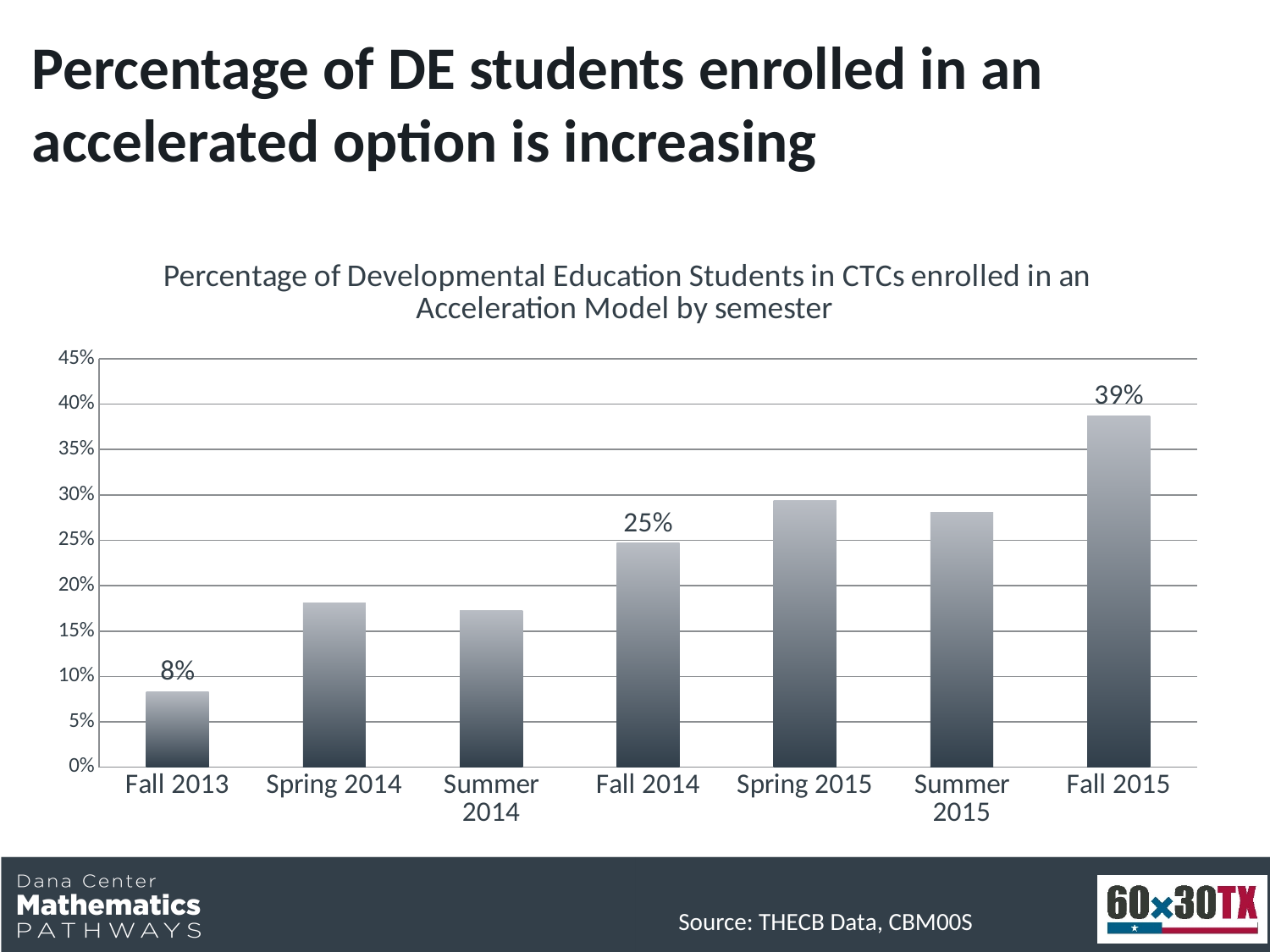
Is the value for Spring 2014 greater or less than 20%? less Which is larger, the value for Spring 2015 or the value for Summer 2014? Spring 2015 Which semester has the highest percentage? Fall 2015 Is the value for Summer 2015 greater or less than 25%? greater What is the difference between the values for Fall 2014 and Fall 2013? 17% What is the value for Fall 2013? 8% What is the value for Fall 2015? 39% How many semesters are shown on the x axis? 7 What is the difference between the values for Fall 2015 and Fall 2013? 31% What kind of chart is shown on the slide? bar chart What is the value for Fall 2014? 25% Which semester has the lowest percentage? Fall 2013